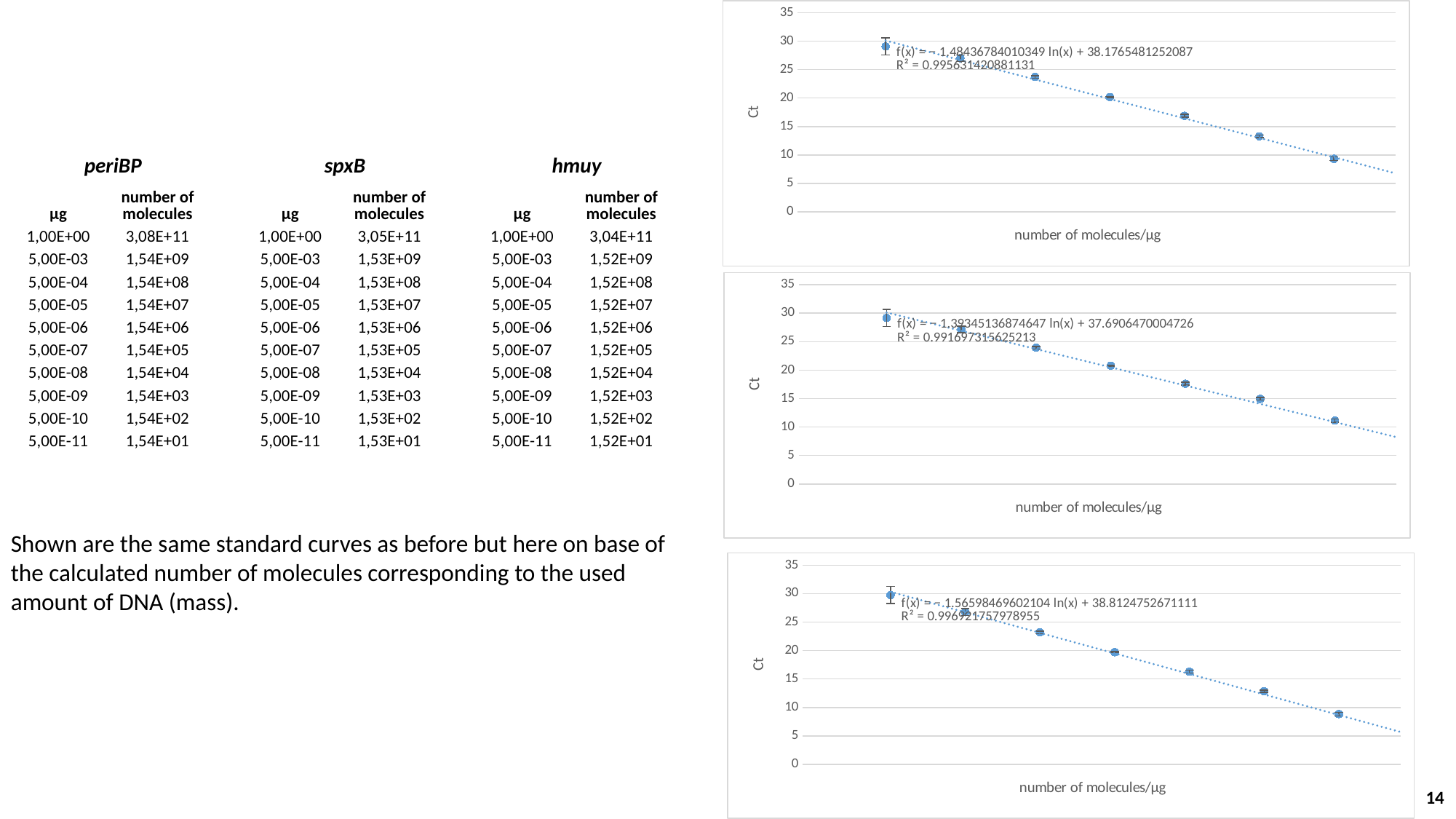
In the top chart, is the Ct value of the rightmost point greater or less than 15? less In the bottom chart, is the Ct value of the rightmost point greater or less than 15? less How many data points are plotted in the bottom chart? 7 How many data points are plotted in the top chart? 7 What is the label of the x axis on the bottom chart? number of molecules/µg What kind of chart is the top chart on the slide? scatter chart In the middle chart, is the Ct value of the leftmost point greater or less than 25? greater How many charts are shown on the slide? 3 What is the R² value printed on the top chart? 0.995631420881131 In the middle chart, do the Ct values rise or fall as the number of molecules/µg increases along the x axis? fall